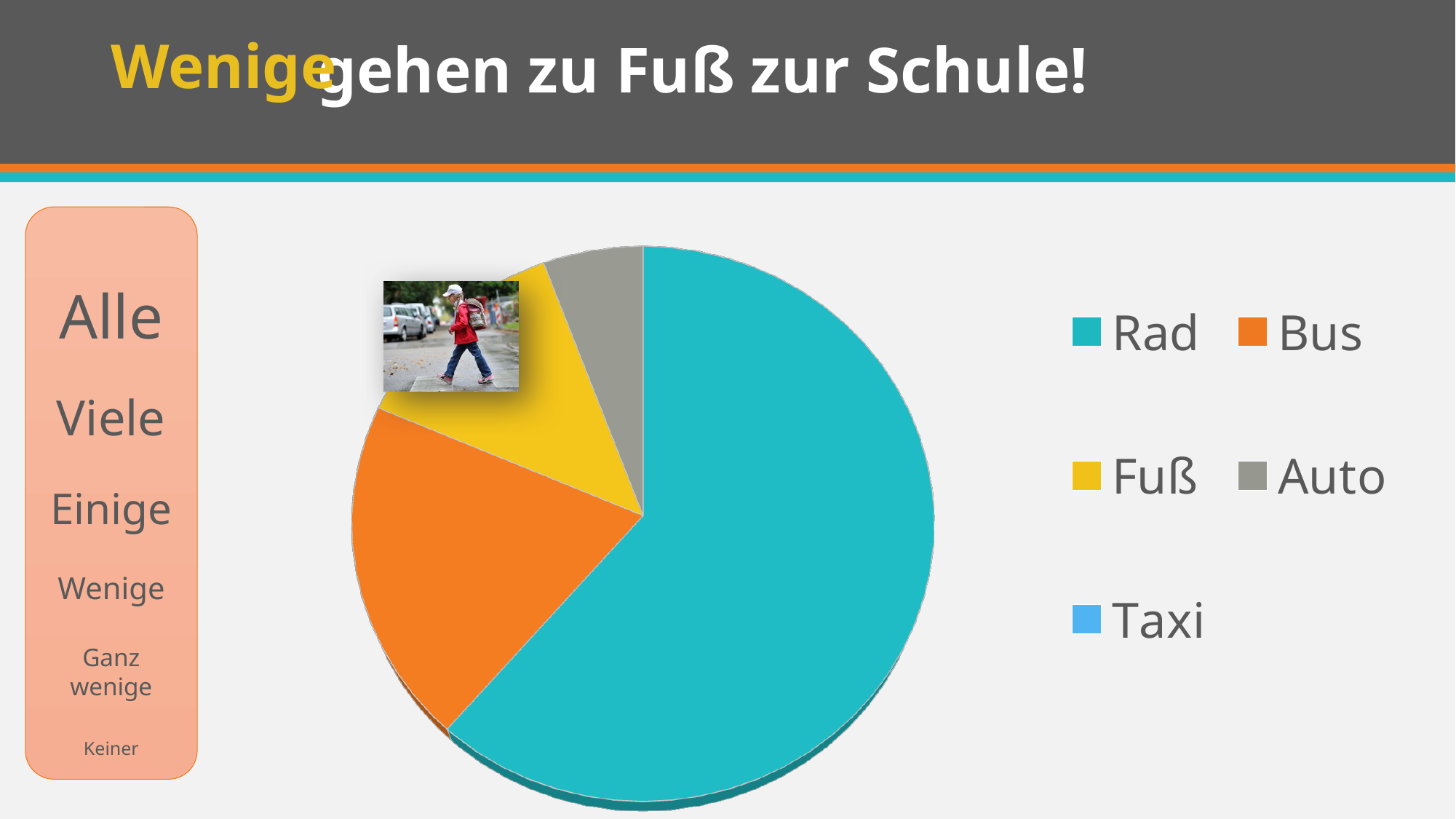
What colour is the Bus slice in the pie chart? orange Which slice is larger, Bus or Auto? Bus Which category has the largest slice of the pie? Rad What kind of chart is shown on the slide? pie chart How many categories does the chart's legend list? 5 Which category is the second-largest slice of the pie? Bus Which slice is larger, Rad or Bus? Rad Which slice is larger, Bus or Fuß? Bus What colour is the Rad slice in the pie chart? teal